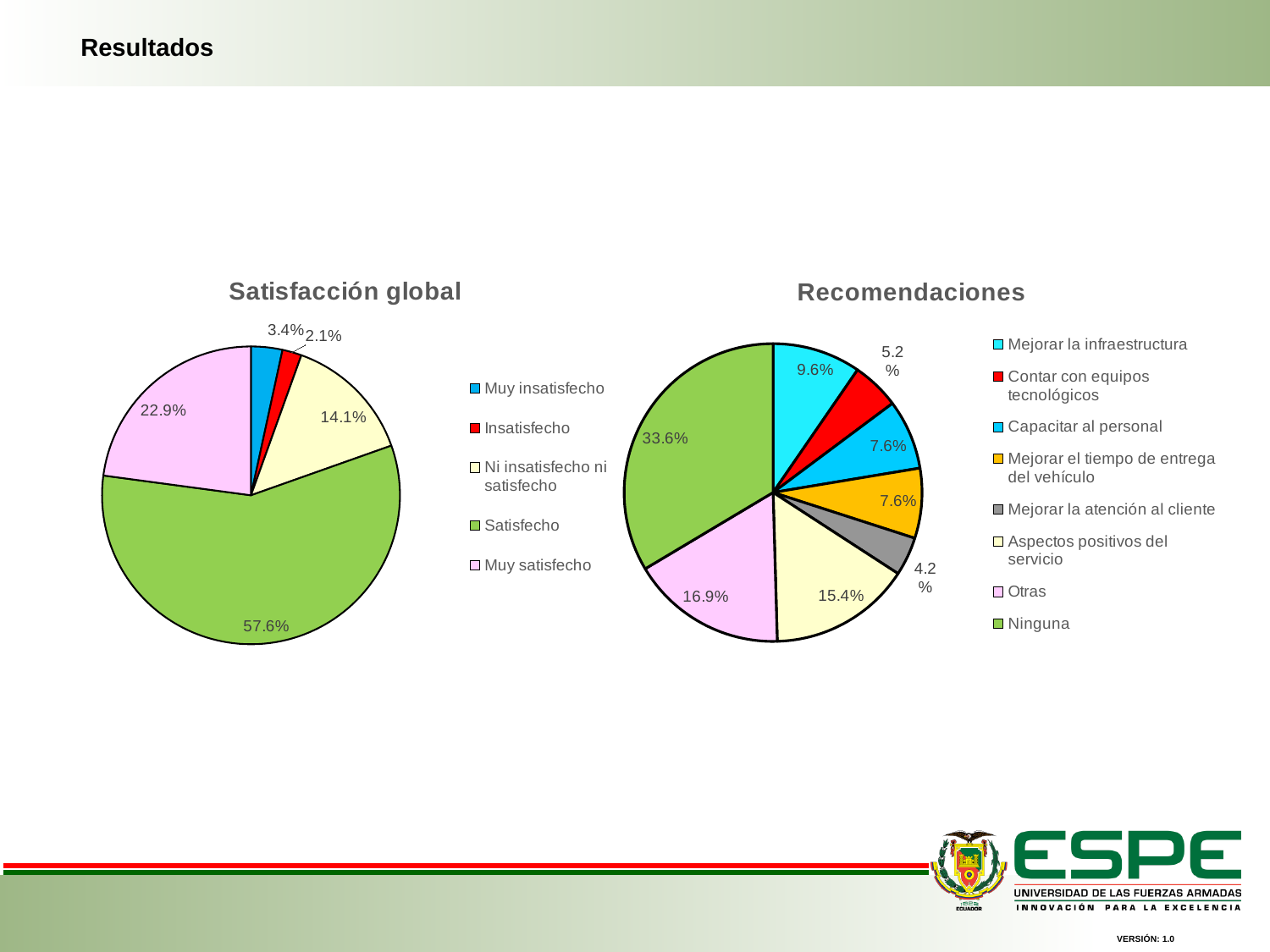
In the 'Recomendaciones' chart, how many categories does the legend list? 8 In the 'Recomendaciones' chart, what share is labelled for Mejorar la infraestructura? 9.6% In the 'Recomendaciones' chart, which is larger: Otras or Aspectos positivos del servicio? Otras What type of chart is 'Recomendaciones'? Pie chart In the 'Satisfacción global' chart, what share is labelled for Satisfecho? 57.6% In the 'Recomendaciones' chart, which category has the largest slice? Ninguna In the 'Satisfacción global' chart, what is the difference between the Satisfecho and Muy satisfecho shares? 34.7% In the 'Recomendaciones' chart, what share is labelled for Ninguna? 33.6% In the 'Satisfacción global' chart, what share is labelled for Muy satisfecho? 22.9% In the 'Recomendaciones' chart, what is the difference between the Otras and Mejorar la atención al cliente shares? 12.7% In the 'Satisfacción global' chart, which category has the smallest slice? Insatisfecho In the 'Satisfacción global' chart, how many categories does the legend list? 5